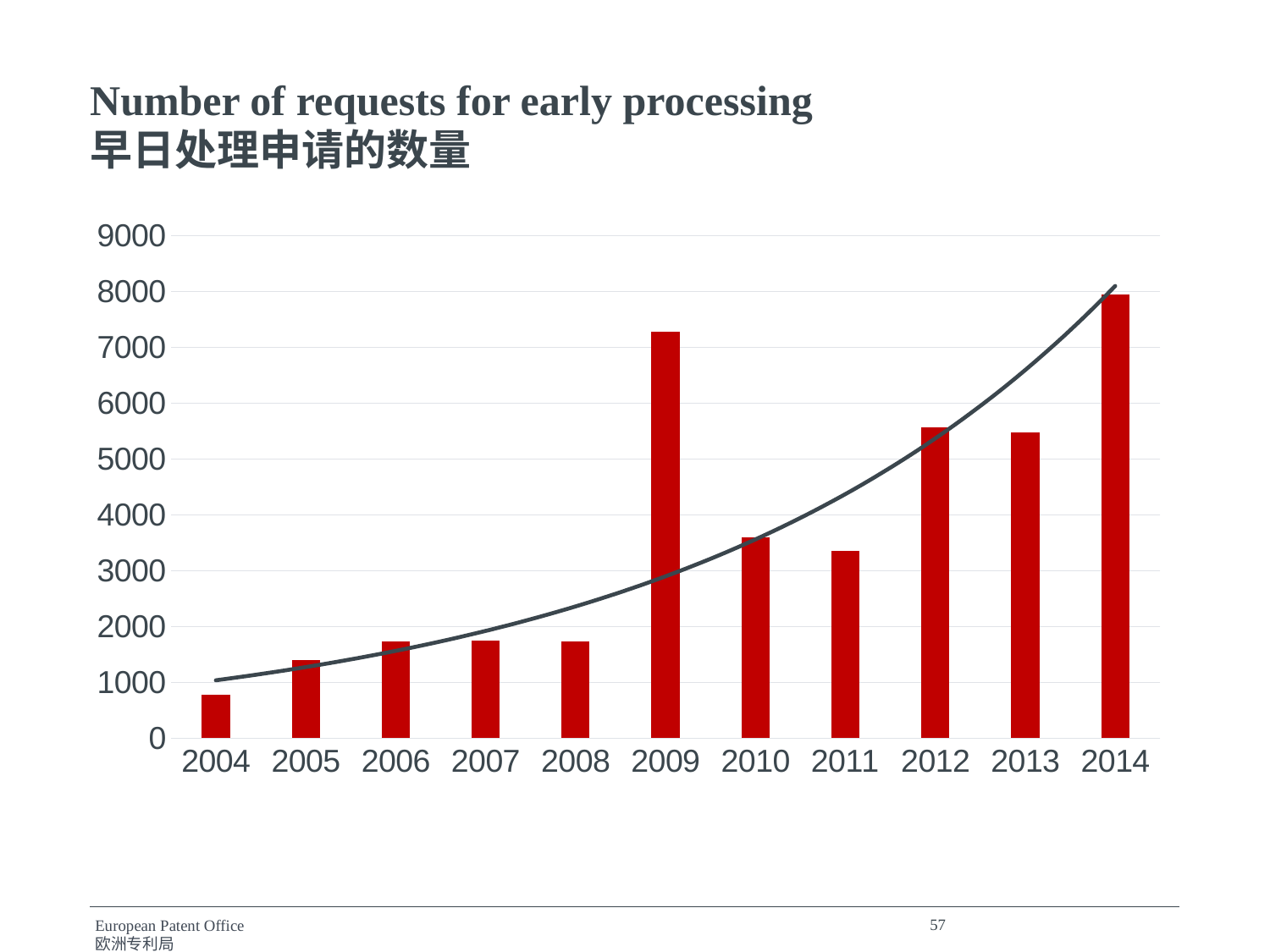
Which year has the highest number of requests for early processing? 2014 Which year has the larger value, 2009 or 2010? 2009 Which year has the larger value, 2012 or 2011? 2012 Is the value for 2004 greater or less than 1000? less Is the value for 2014 greater or less than 7000? greater Is the value for 2011 greater or less than 4000? less Which year has the lowest number of requests for early processing? 2004 What is the English title of the chart on the slide? Number of requests for early processing What kind of chart is shown on the slide? bar chart How many years are shown on the x axis of the chart? 11